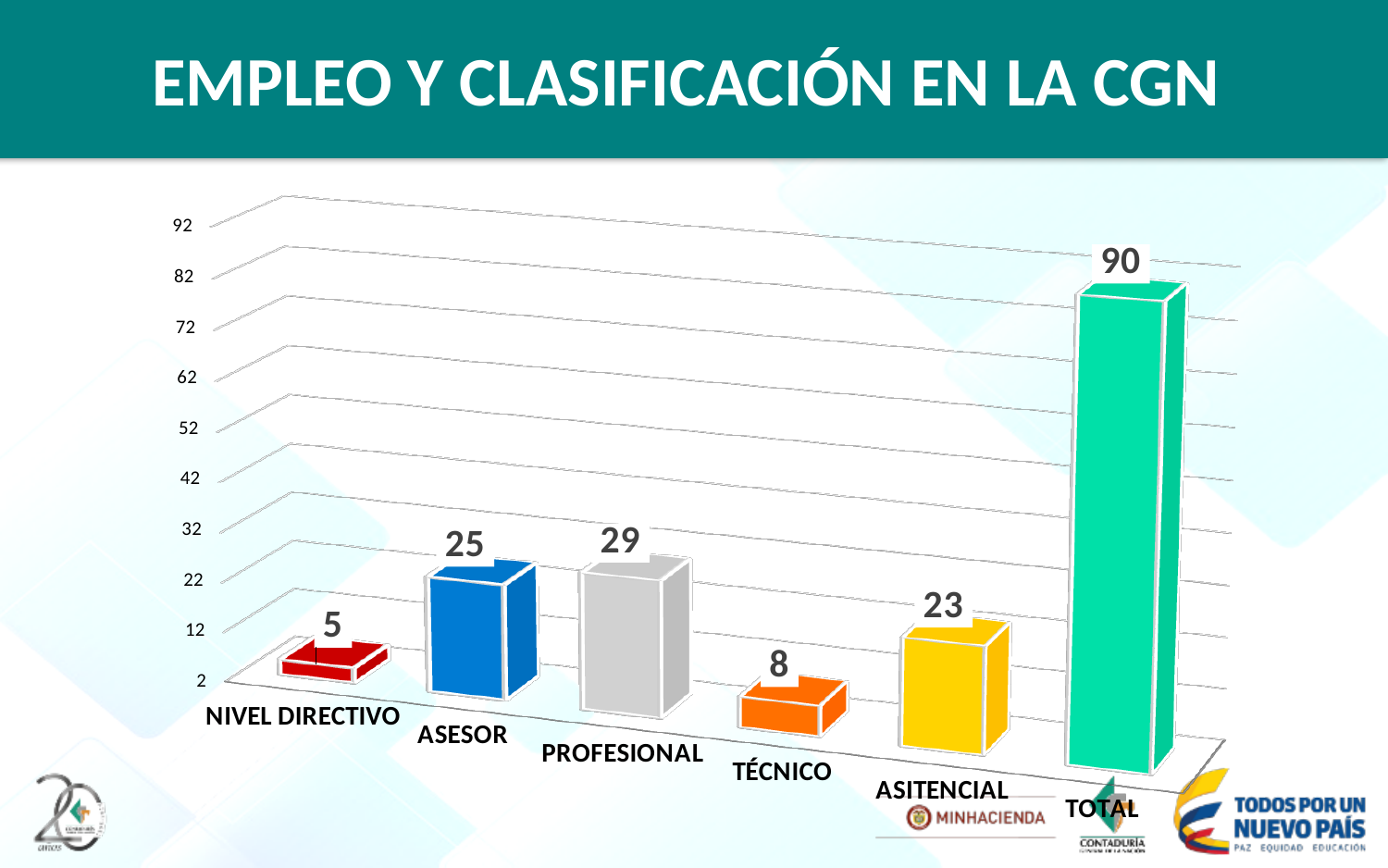
What is the value shown for TOTAL? 90 Excluding the TOTAL bar, which category has the highest value? PROFESIONAL Which category has the lowest value? NIVEL DIRECTIVO What is the value for ASITENCIAL? 23 What is the value for PROFESIONAL? 29 What is the difference between the values for PROFESIONAL and ASESOR? 4 What is the title of the slide? EMPLEO Y CLASIFICACIÓN EN LA CGN What is the value for ASESOR? 25 What kind of chart is shown on the slide? Bar chart How many bars are shown in the chart? 6 Which is larger, the value for TÉCNICO or the value for ASITENCIAL? ASITENCIAL What is the value for NIVEL DIRECTIVO? 5